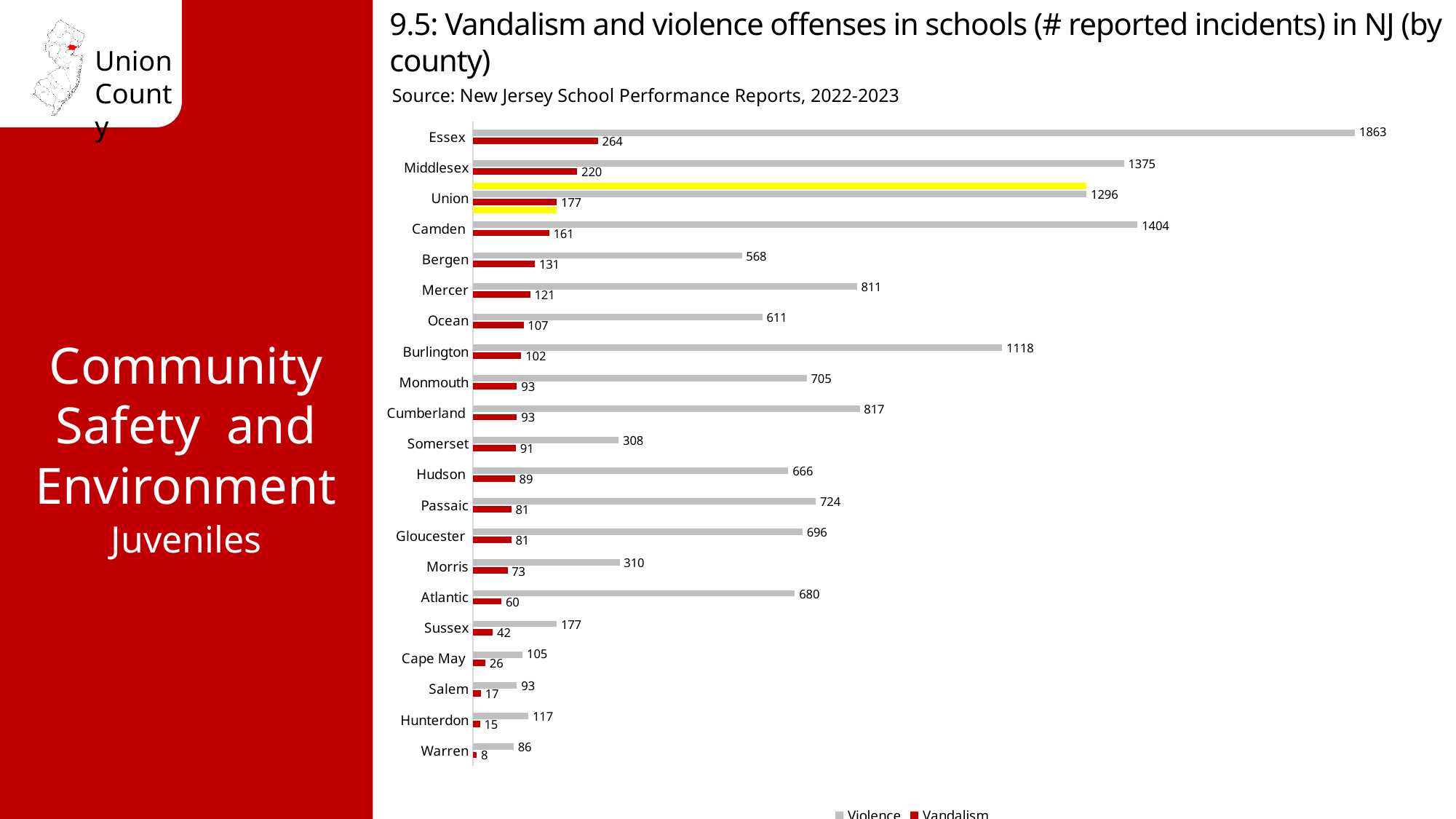
What is the number of reported violence incidents in Essex County? 1863 Which series is shown in red in the chart? Vandalism What is the difference between the violence incidents in Camden and Middlesex? 29 What is the number of reported vandalism incidents in Union County? 177 How many series does the legend list? 2 Which county has more reported violence incidents, Burlington or Mercer? Burlington Which county has the lowest number of reported vandalism incidents? Warren What is the difference between vandalism incidents in Essex and Middlesex? 44 Which county has the highest number of reported violence incidents? Essex What is the number of reported violence incidents in Cape May County? 105 How many counties are shown in the chart? 21 What kind of chart is shown on the slide? Bar chart